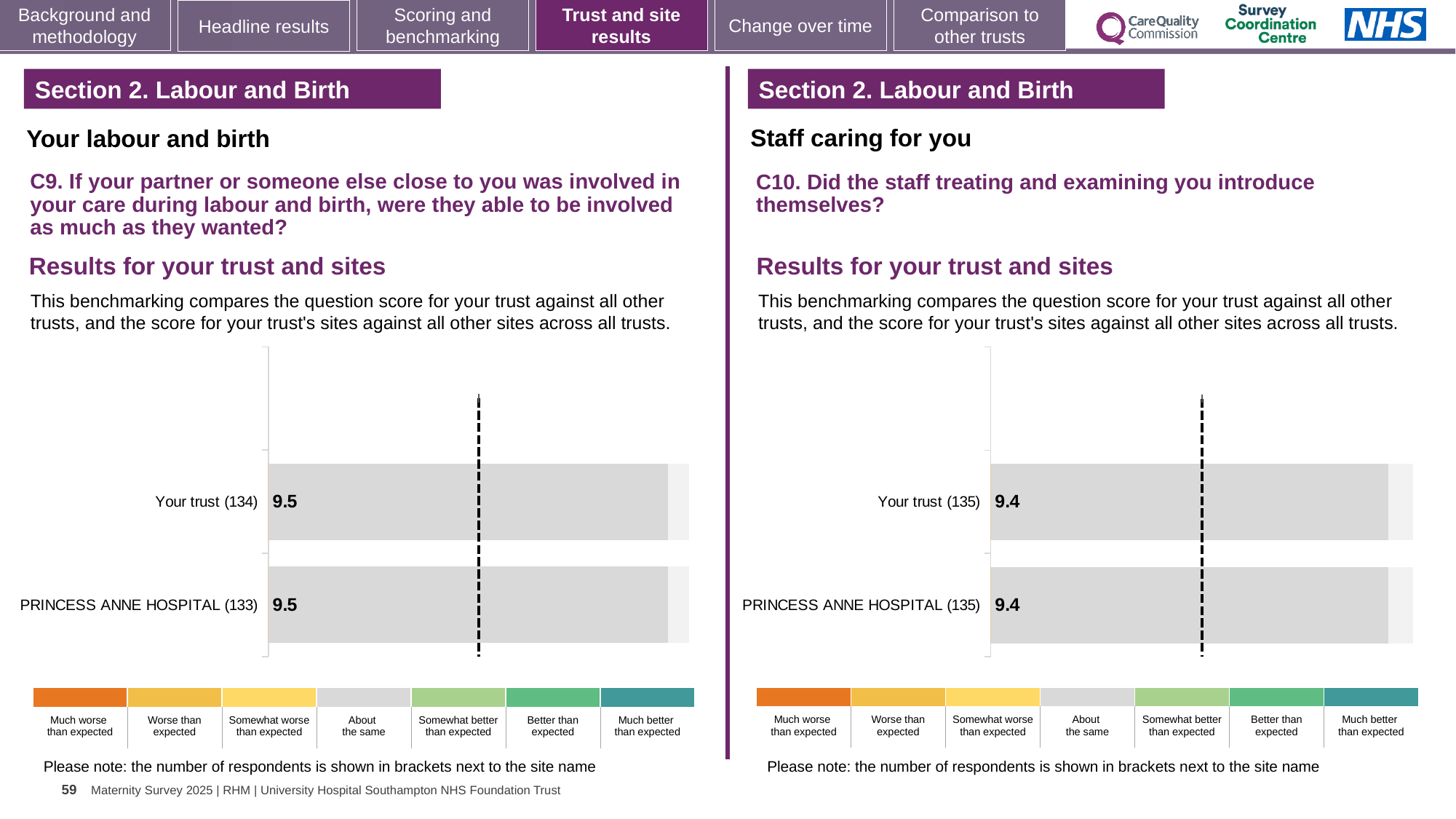
In the left chart (C9), what is the score for PRINCESS ANNE HOSPITAL? 9.5 What kind of chart is used in the left chart (C9)? Bar chart Is the score for Your trust in the right chart (C10) greater or less than the score for Your trust in the left chart (C9)? less In the right chart (C10), what is the score for PRINCESS ANNE HOSPITAL? 9.4 In the right chart (C10), what is the score for Your trust? 9.4 In the left chart (C9), how many respondents are shown in brackets for Your trust? 134 How many bars are plotted in the right chart (C10)? 2 In the left chart (C9), what is the difference between the score for Your trust and the score for PRINCESS ANNE HOSPITAL? 0 In the right chart (C10), what is the difference between the score for Your trust and the score for PRINCESS ANNE HOSPITAL? 0 In the right chart (C10), how many respondents are shown in brackets for PRINCESS ANNE HOSPITAL? 135 In the left chart (C9), what is the score for Your trust? 9.5 How many bars are plotted in the left chart (C9)? 2